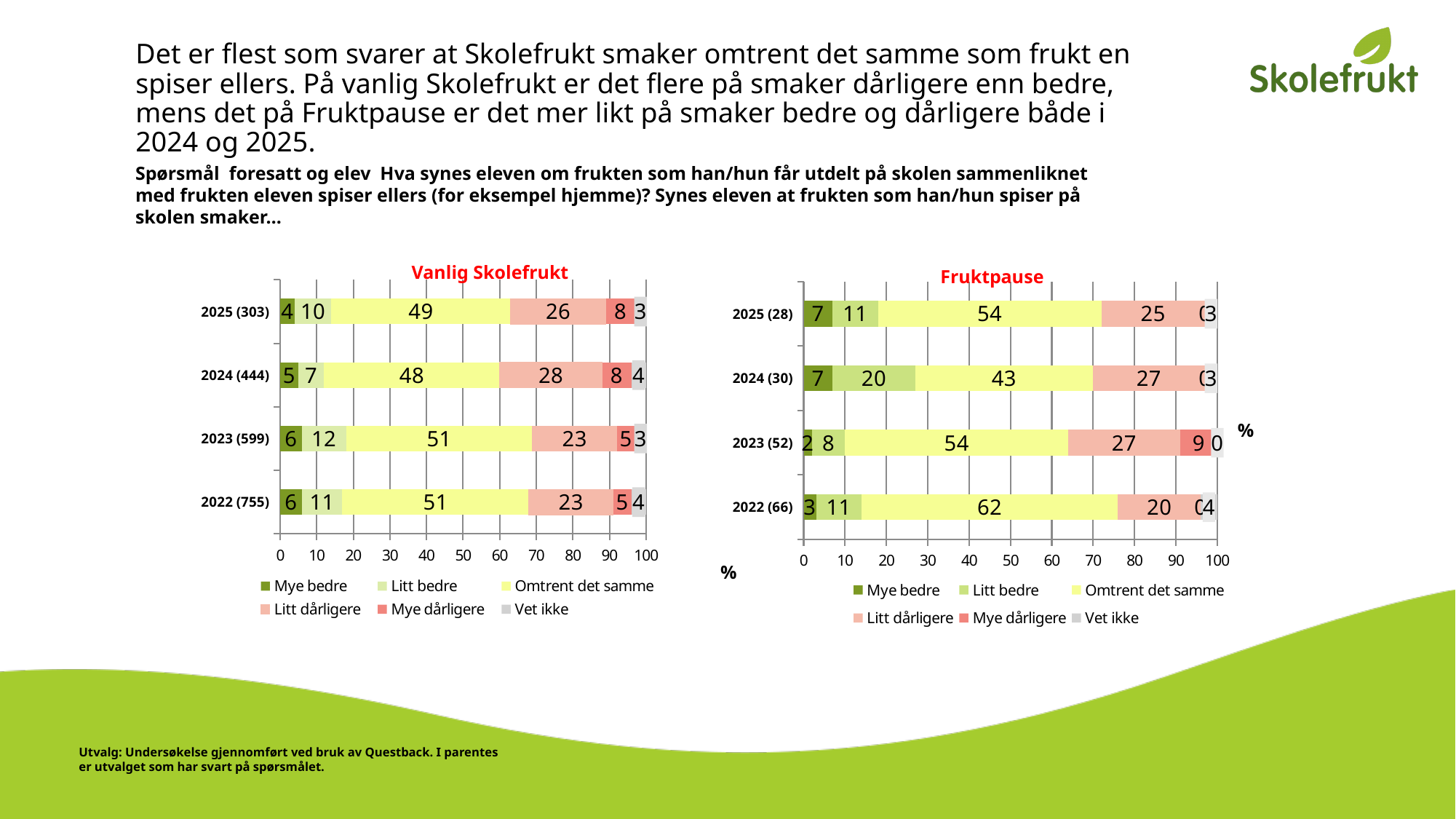
How many year categories does the Vanlig Skolefrukt chart show? 4 In the Vanlig Skolefrukt chart, what is the difference between Litt dårligere in 2024 (444) and in 2023 (599)? 5 In the Fruktpause chart, what is the value for Omtrent det samme in 2022 (66)? 62 What type of chart is the Vanlig Skolefrukt chart? Stacked bar chart In the Vanlig Skolefrukt chart, which year has the lowest value for Litt bedre? 2024 (444) In the Fruktpause chart, which is larger: Mye dårligere in 2023 (52) or Litt bedre in 2023 (52)? Mye dårligere in 2023 (52) In the Vanlig Skolefrukt chart, what is the value for Omtrent det samme in 2025 (303)? 49 What is the title of the chart on the right side of the slide? Fruktpause How many series does the legend of the Fruktpause chart list? 6 In the Fruktpause chart, what is the value for Litt bedre in 2024 (30)? 20 In the Vanlig Skolefrukt chart, what is the value for Litt dårligere in 2024 (444)? 28 In the Fruktpause chart, which year has the highest value for Omtrent det samme? 2022 (66)